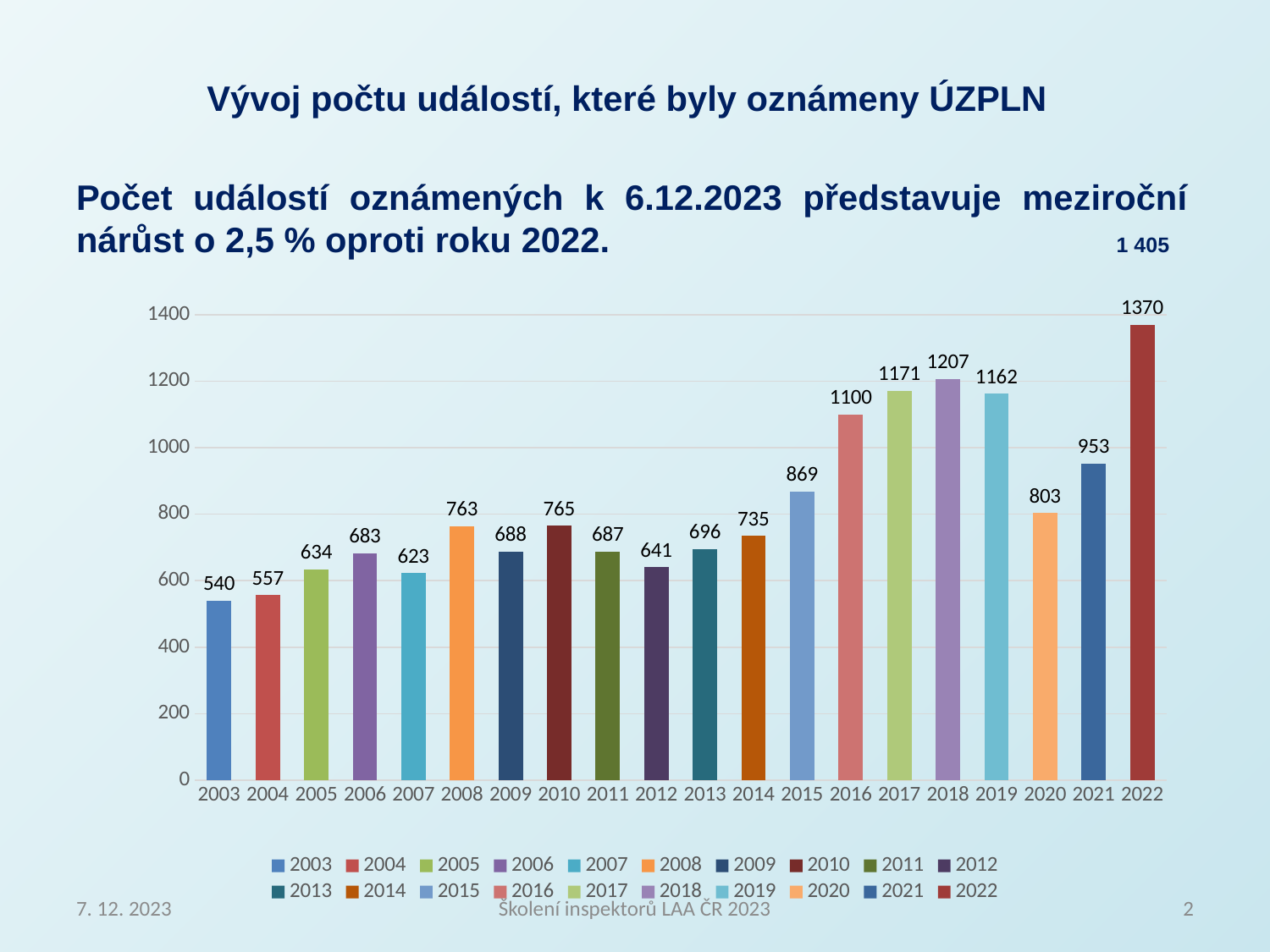
Which is larger, the value for 2015 or the value for 2020? 2015 Which year has the highest value? 2022 Which year has the lowest value? 2003 What is the value for 2016? 1100 What is the value for 2012? 641 Do the values rise or fall from 2016 to 2018? rise What type of chart is shown on the slide? bar chart How many entries does the chart legend list? 20 What is the value for 2022? 1370 How many years (bars) are plotted in the chart? 20 What is the difference between the values for 2022 and 2021? 417 What is the difference between the values for 2018 and 2017? 36